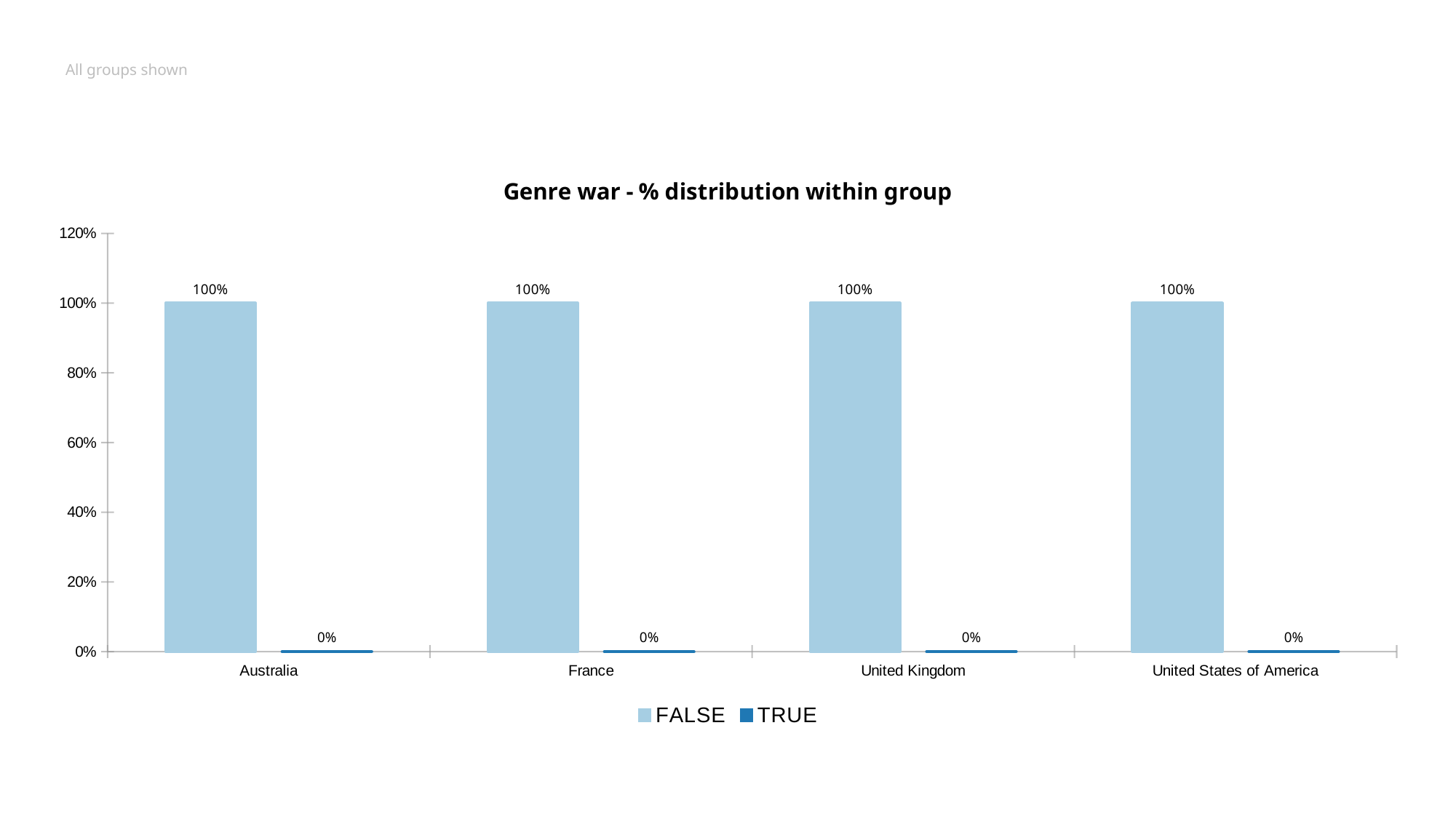
What is the TRUE value for United States of America? 0% What is the difference between the FALSE and TRUE values for United Kingdom? 100% What is the FALSE value for Australia? 100% What are the two series named in the legend? FALSE and TRUE How many series does the legend list? 2 What is the FALSE value for United Kingdom? 100% What is the TRUE value for France? 0% Which is larger for France, the FALSE value or the TRUE value? FALSE What kind of chart is shown? bar chart How many categories are shown on the x axis? 4 What is the title of the chart? Genre war - % distribution within group Is the FALSE value for Australia greater or less than 80%? greater